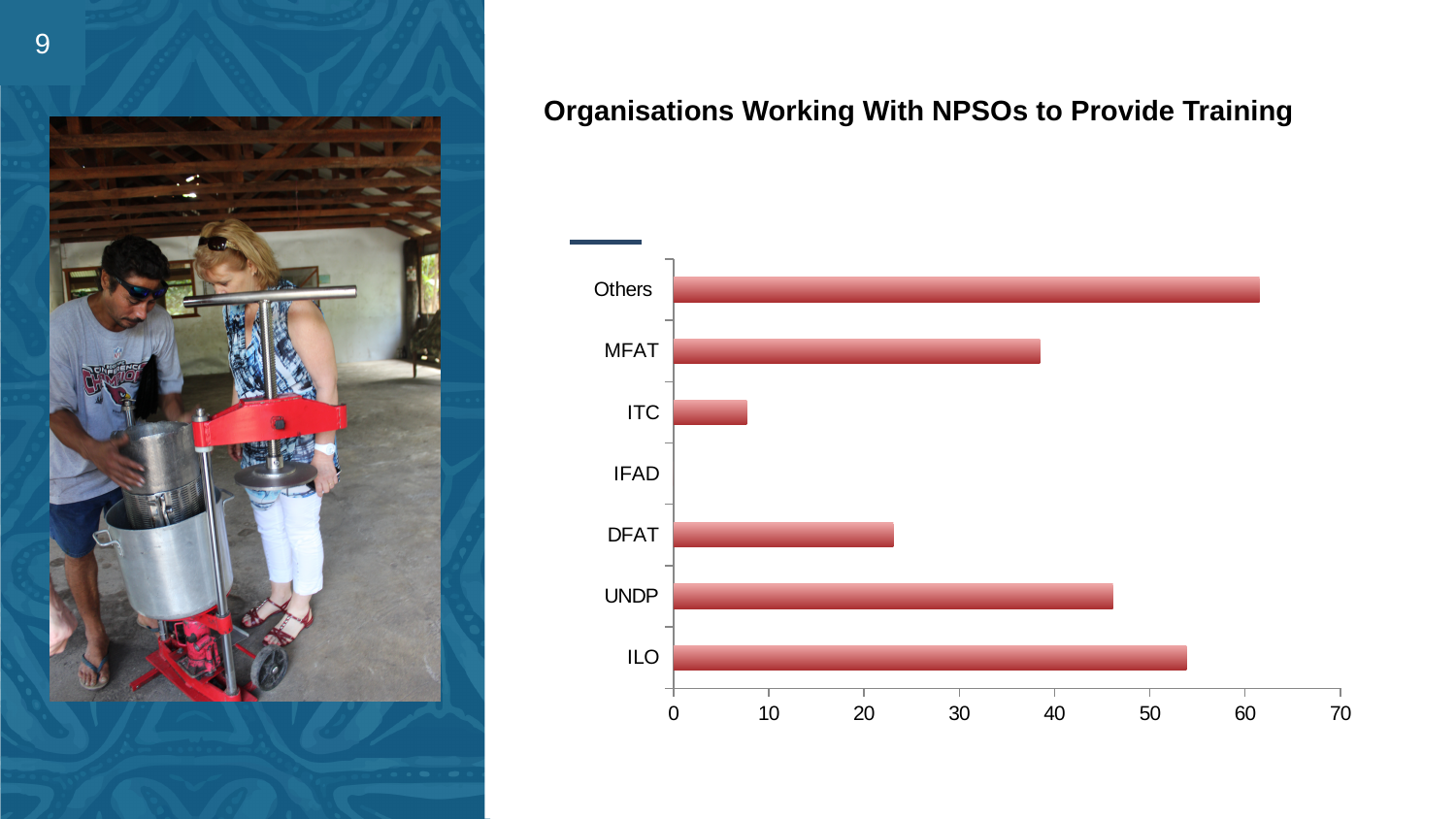
Is the value for UNDP greater or less than 50? less Is the value for MFAT greater or less than 30? greater Is the value for DFAT greater or less than 20? greater What is the title of the chart? Organisations Working With NPSOs to Provide Training What kind of chart is shown on the slide? bar chart How many organisations are listed on the chart's vertical axis? 7 Which organisation has the longest bar? Others Which organisation has the smallest value on the chart? IFAD Which has the larger value, MFAT or DFAT? MFAT Which has the larger value, ILO or UNDP? ILO